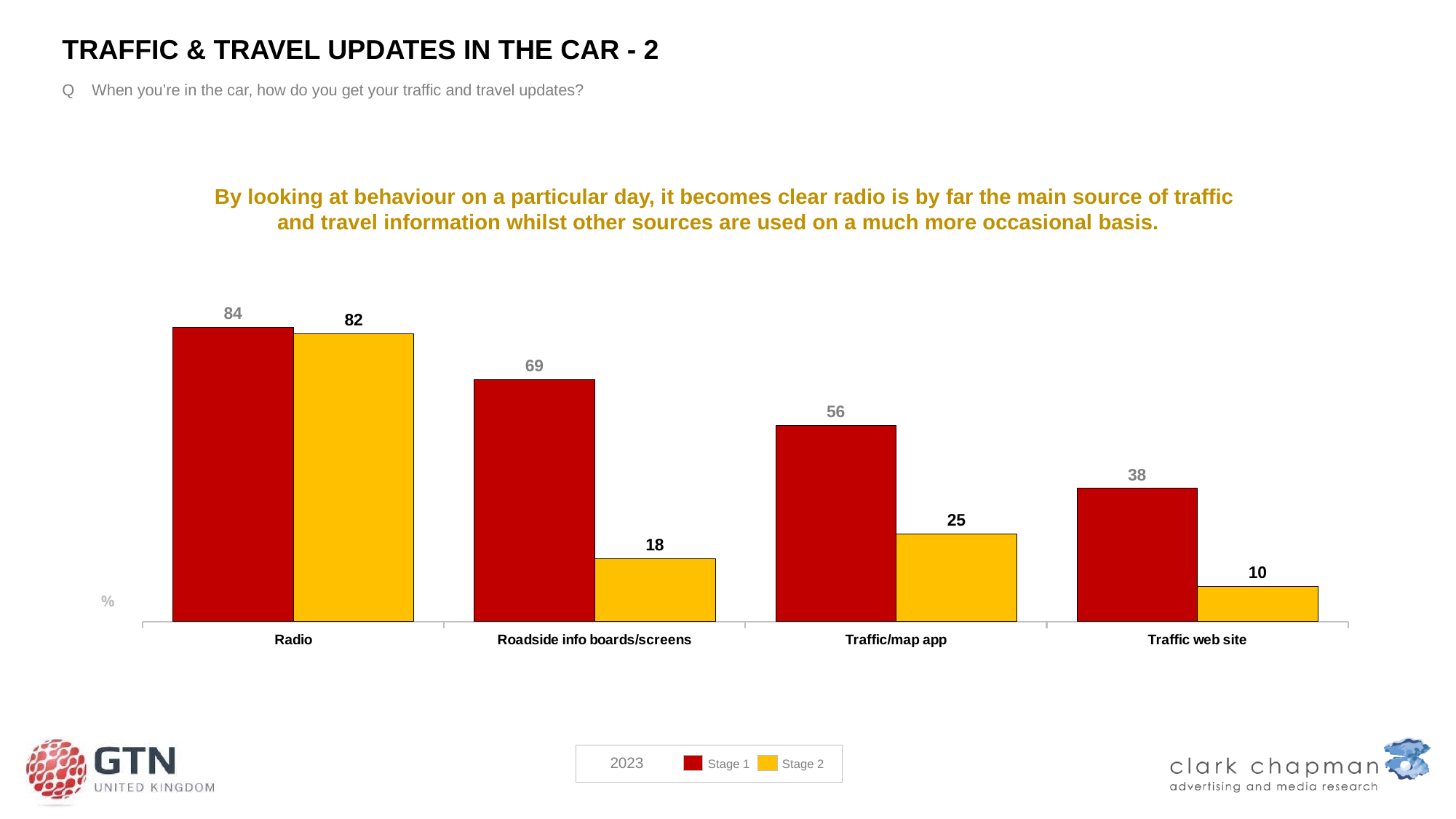
What is the Stage 2 value for Traffic web site? 10 What is the Stage 2 value for Roadside info boards/screens? 18 Which is larger: the Stage 2 value for Traffic/map app or the Stage 2 value for Roadside info boards/screens? Traffic/map app Which category has the highest Stage 2 value? Radio What is the Stage 1 value for Traffic/map app? 56 How many categories are shown on the x axis? 4 What is the Stage 1 value for Radio? 84 What is the difference between the Stage 1 and Stage 2 values for Roadside info boards/screens? 51 Which colour represents Stage 2 in the legend? Yellow What kind of chart is shown on the slide? Bar chart How many series does the legend list? 2 Which category has the lowest Stage 1 value? Traffic web site